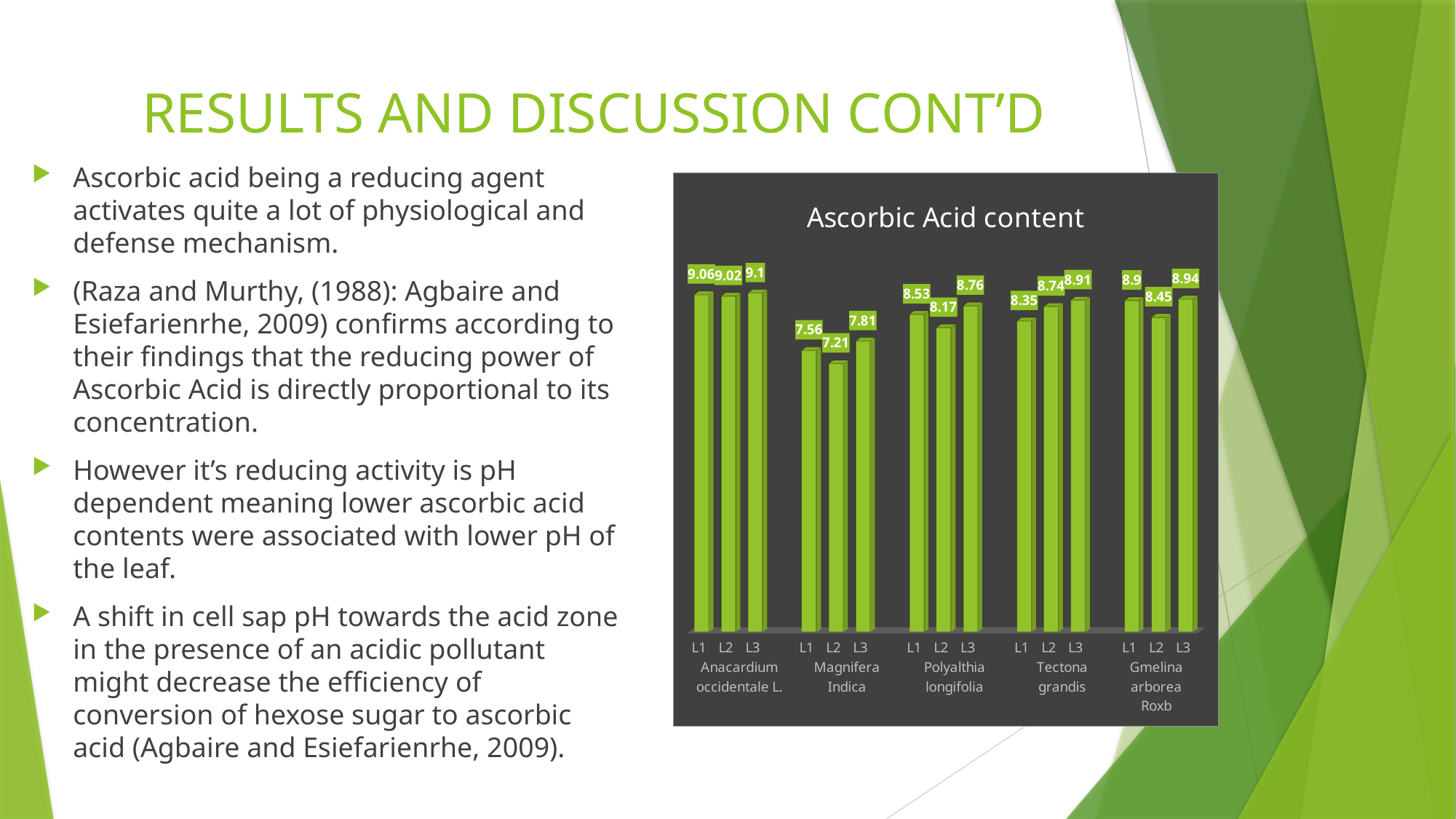
What is the difference between the L3 and L1 values for Tectona grandis? 0.56 Which is larger, the L1 value for Gmelina arborea Roxb or the L1 value for Tectona grandis? Gmelina arborea Roxb L1 (8.9) What is the title of the chart? Ascorbic Acid content What is the value shown for L1 of Polyalthia longifolia? 8.53 Which bar has the highest value in the chart? L3 of Anacardium occidentale L. (9.1) What is the value shown for L2 of Gmelina arborea Roxb? 8.45 How many plant species groups are shown on the x axis of the chart? 5 What is the difference between the L3 and L2 values for Polyalthia longifolia? 0.59 What is the value shown for L3 of Tectona grandis? 8.91 What kind of chart is shown on the slide? bar chart Which bar has the lowest value in the chart? L2 of Magnifera Indica (7.21) What is the ascorbic acid content value for L1 of Magnifera Indica? 7.56